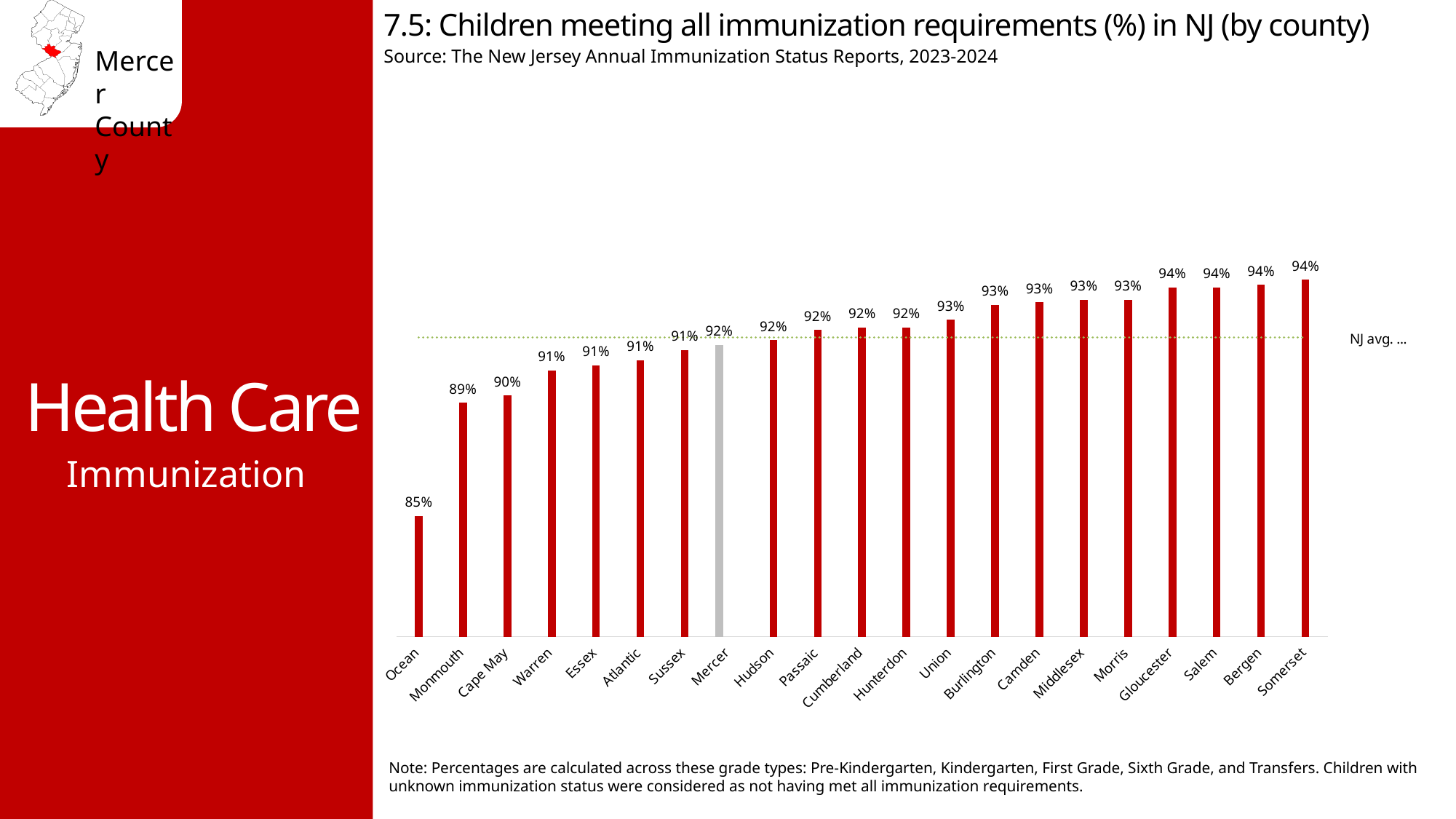
What percentage of children in Ocean County met all immunization requirements? 85% Which county has the lowest percentage of children meeting all immunization requirements? Ocean How many counties are shown on the chart? 21 What is the value shown for Mercer County? 92% Which has a higher value, Monmouth or Ocean? Monmouth Which has a higher value, Cape May or Union? Union What is the difference in percentage points between Somerset and Ocean? 9 percentage points Do the values generally rise or fall moving from left to right across the counties? Rise What kind of chart is shown on the slide? Bar chart How many percentage points higher is Mercer than Ocean? 7 percentage points What is the value shown for Somerset County? 94% What percentage is shown for Cape May? 90%